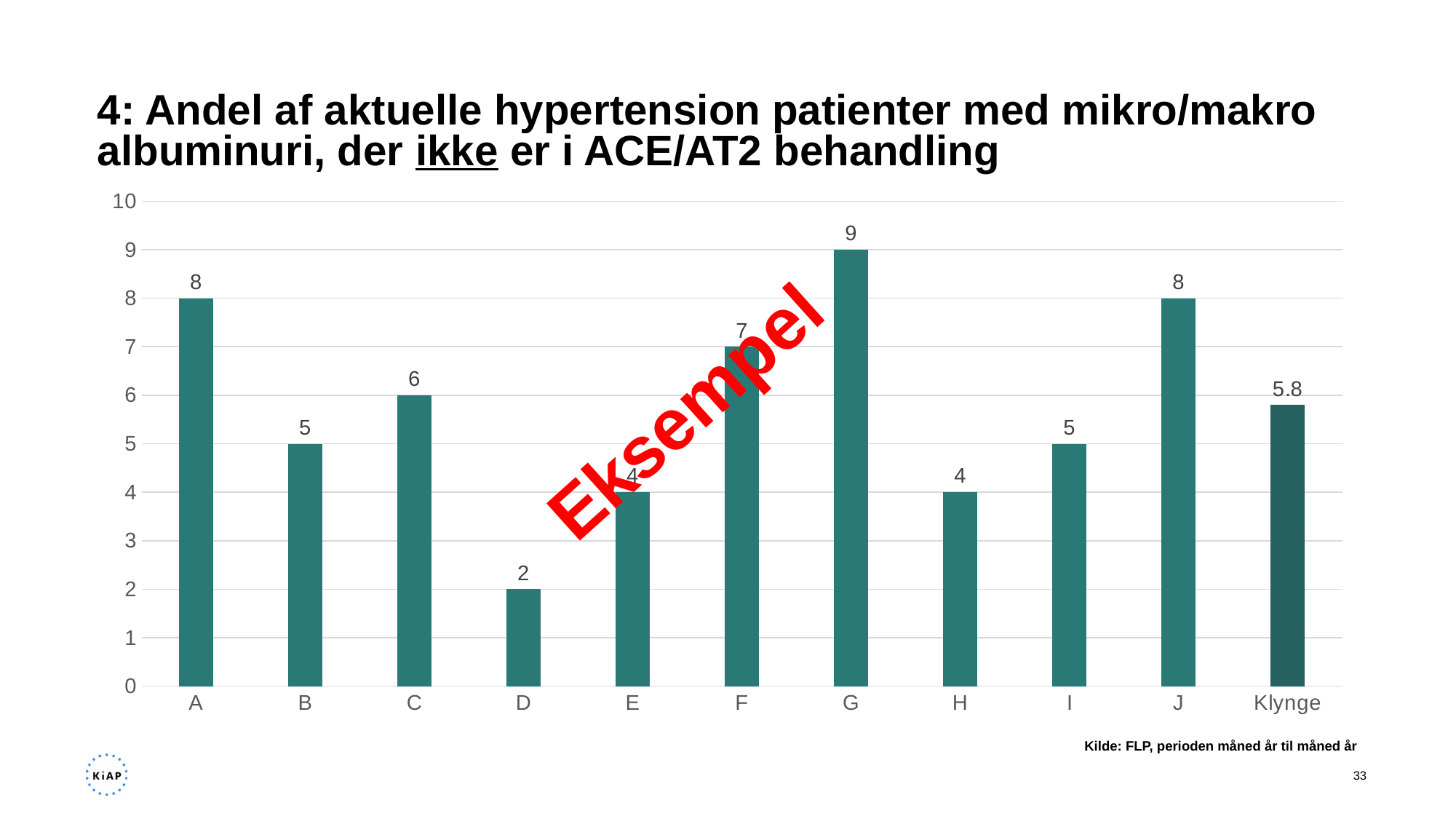
What is the difference between the values for G and D? 7 What is the value for category D? 2 Which category has the highest value? G Which is larger, the value for C or the value for H? C Which category has the lowest value? D What is the value for category G? 9 What kind of chart is shown on the slide? Bar chart What red word is overlaid diagonally across the chart? Eksempel How many categories are shown on the x axis? 11 What is the difference between the values for A and B? 3 What is the value for Klynge? 5.8 Is the value for F greater or less than 5? greater